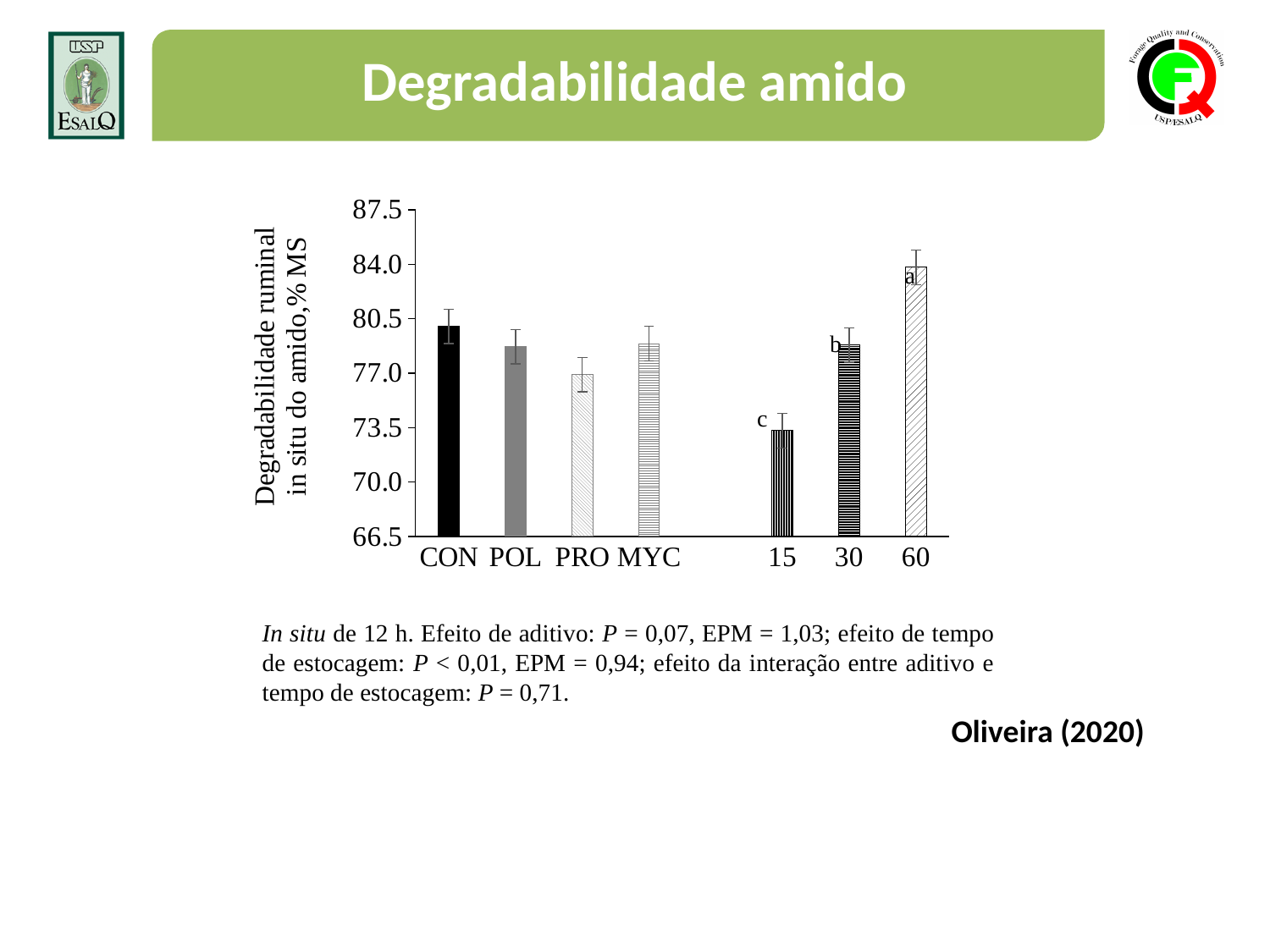
Is the value for 60 greater or less than 80.5? greater What is the label of the y axis? Degradabilidade ruminal in situ do amido, % MS Is the value for PRO greater or less than 80.5? less Which is larger, the value for CON or the value for PRO? CON Which is larger, the value for 30 or the value for 15? 30 Which category has the highest starch degradability? 60 What kind of chart is shown on the slide? bar chart Is the value for CON greater or less than 77.0? greater Which category has the lowest starch degradability? 15 Which letter is printed next to the bar for 60? a How many bars (categories) are plotted in the chart? 7